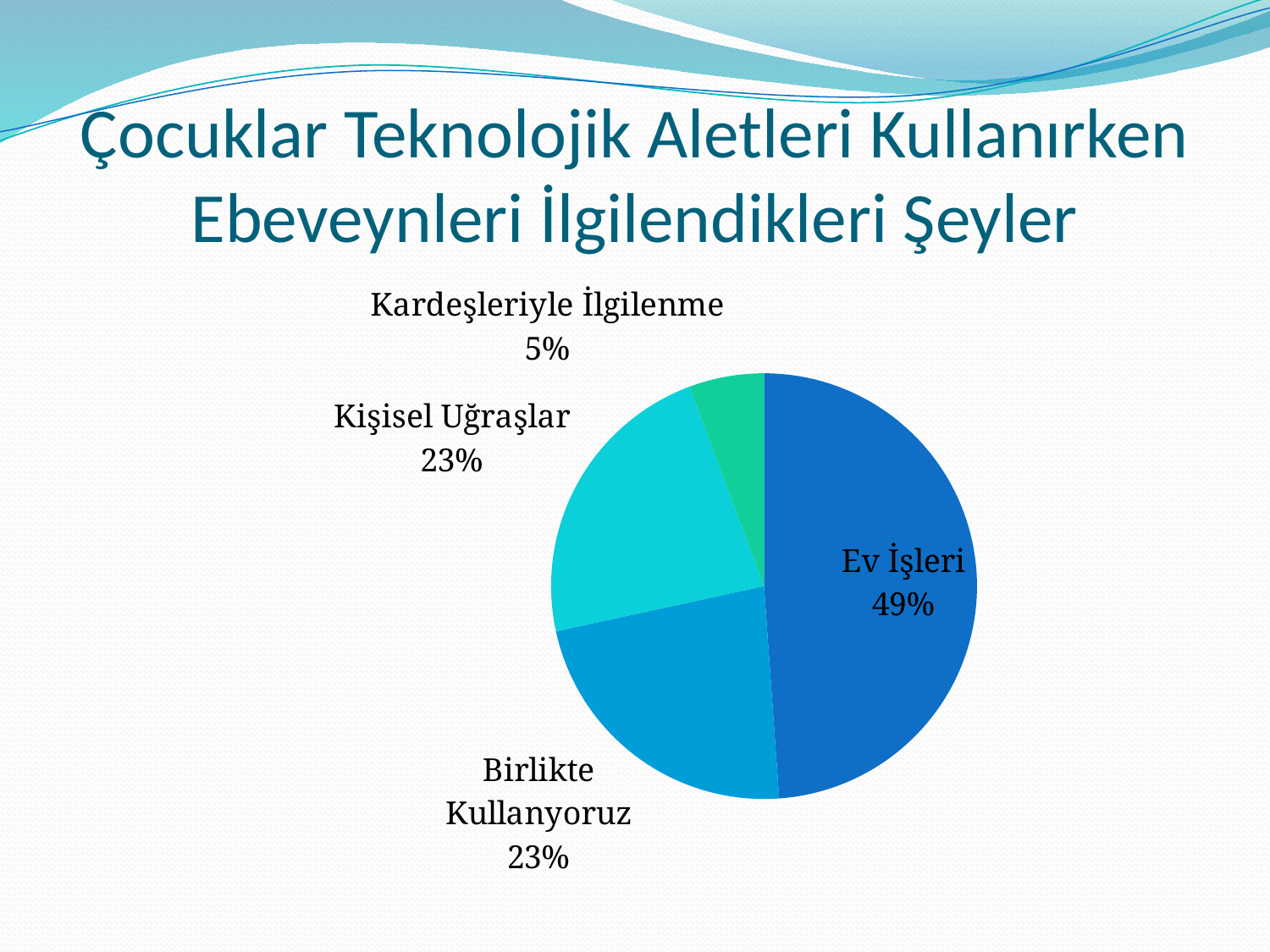
What percentage is shown for Birlikte Kullanyoruz? 23% Which category has the largest share of the pie? Ev İşleri What kind of chart is shown on the slide? pie chart What percentage is shown for Kardeşleriyle İlgilenme? 5% What is the title of the slide containing the pie chart? Çocuklar Teknolojik Aletleri Kullanırken Ebeveynleri İlgilendikleri Şeyler What is the difference in percentage points between Ev İşleri and Kişisel Uğraşlar? 26 Which category has the smallest share of the pie? Kardeşleriyle İlgilenme Which is larger, the share for Ev İşleri or the share for Kardeşleriyle İlgilenme? Ev İşleri How many slices does the pie chart have? 4 What percentage is shown for Ev İşleri? 49% What is the difference in percentage points between Birlikte Kullanyoruz and Kardeşleriyle İlgilenme? 18 What percentage is shown for Kişisel Uğraşlar? 23%